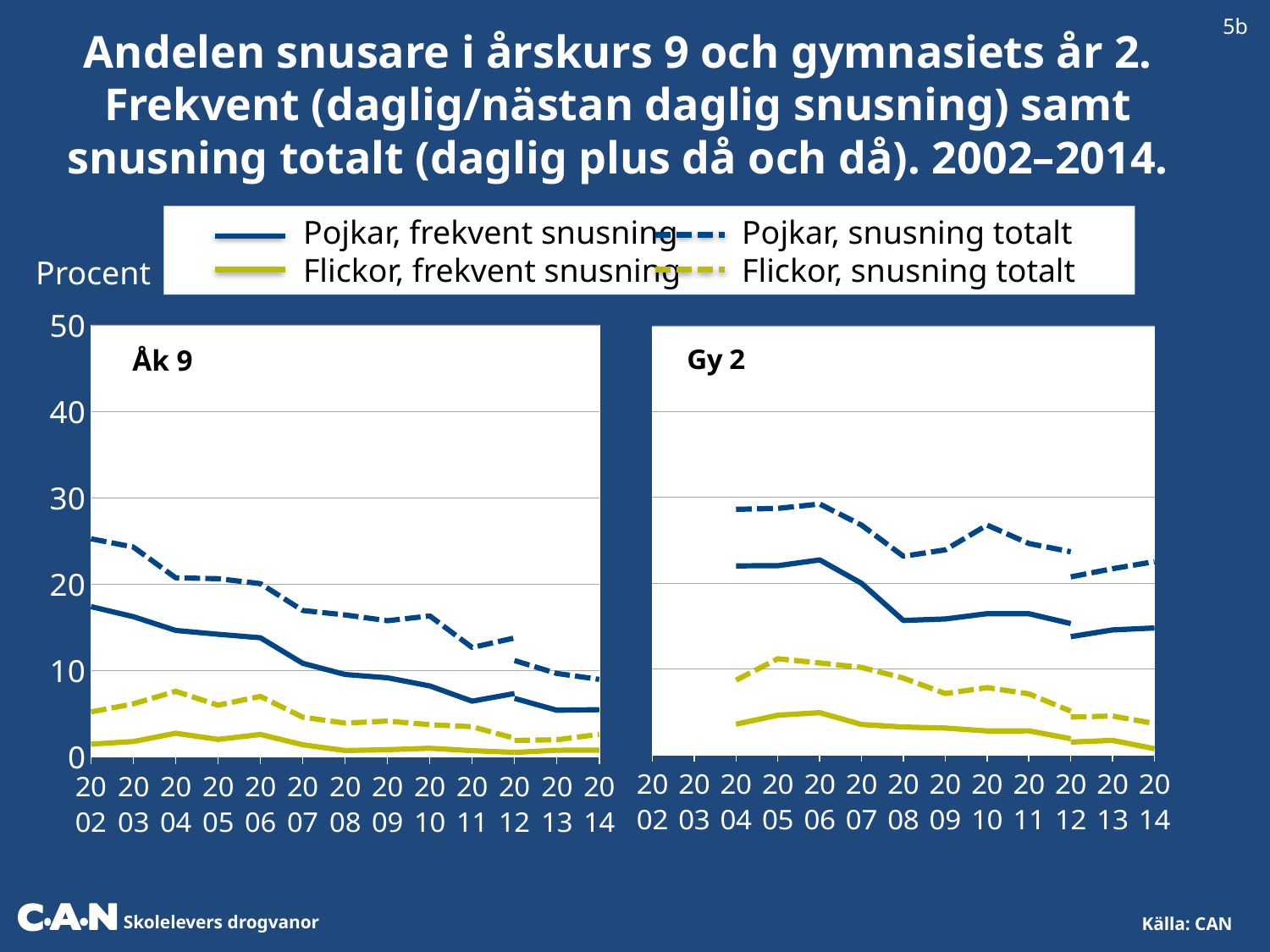
How many years are labelled on the x axis of the Åk 9 chart? 13 In the Gy 2 chart, is the value for Pojkar, frekvent snusning in 2008 greater or less than 20? less In the Åk 9 chart, is the value for Pojkar, frekvent snusning in 2014 greater or less than 10? less What is the label on the y axis of the charts? Procent In the Gy 2 chart, does the Pojkar, frekvent snusning line rise or fall overall from 2004 to 2014? fall In the Åk 9 chart, does the Pojkar, frekvent snusning line rise or fall from 2002 to 2014? fall In the Åk 9 chart, which year has the highest value for Pojkar, snusning totalt? 2002 In the Gy 2 chart, is the value for Pojkar, snusning totalt in 2006 greater or less than 20? greater How many series does the legend list? 4 What kind of chart is the Åk 9 chart? line chart In the Gy 2 chart, which is larger in 2014: Pojkar, snusning totalt or Flickor, snusning totalt? Pojkar, snusning totalt